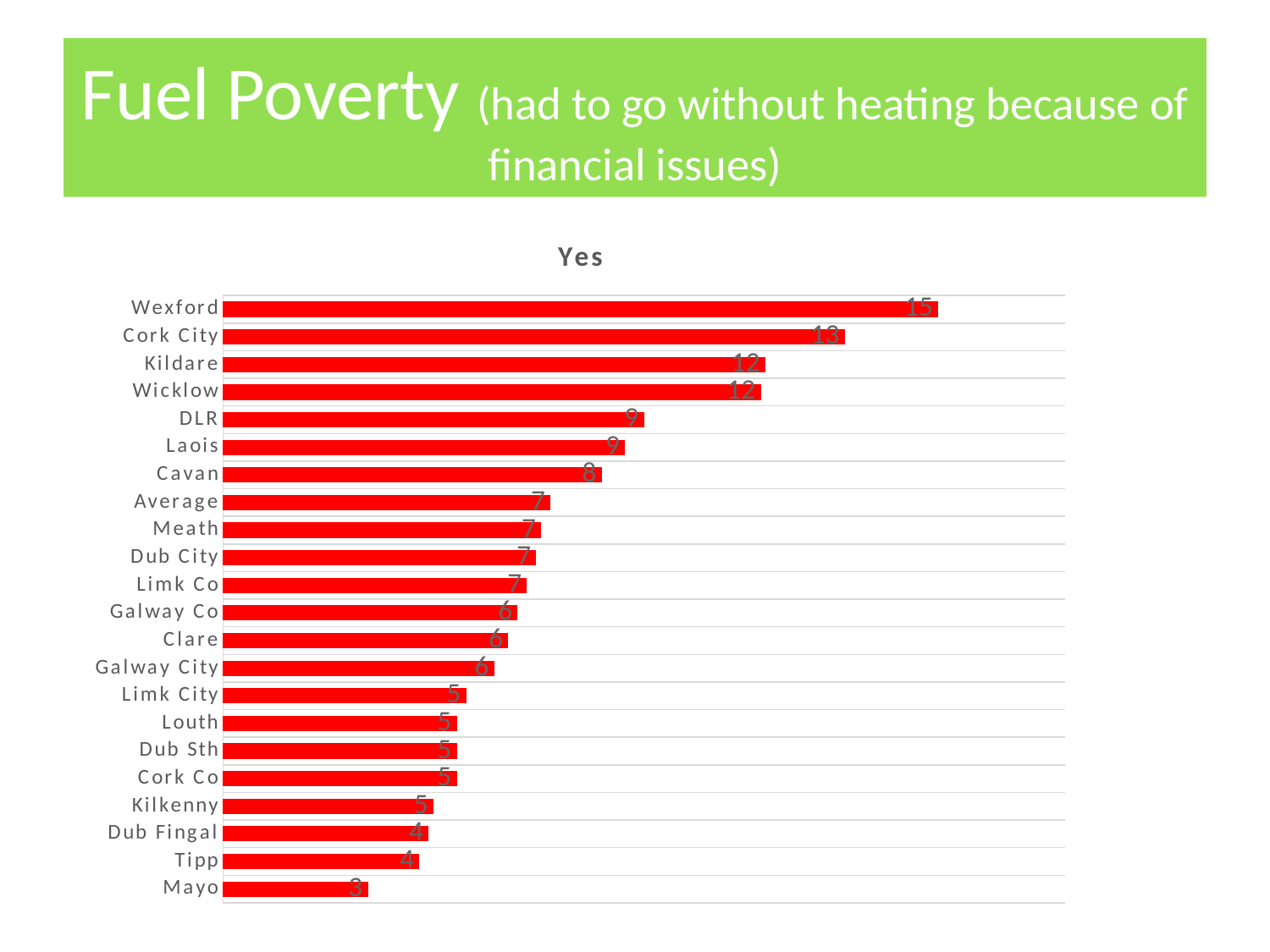
What is the value for Cork City? 13 Which category has the highest value? Wexford What is the difference between the values for Wexford and Cork City? 2 What is the value shown for Average? 7 What is the difference between the values for Kildare and Mayo? 9 Which has a larger value, DLR or Cavan? DLR What is the value for Mayo? 3 What is the title of the chart? Yes How many categories are shown on the chart? 22 What is the value for Wexford? 15 Which category has the lowest value? Mayo What kind of chart is shown on the slide? Bar chart